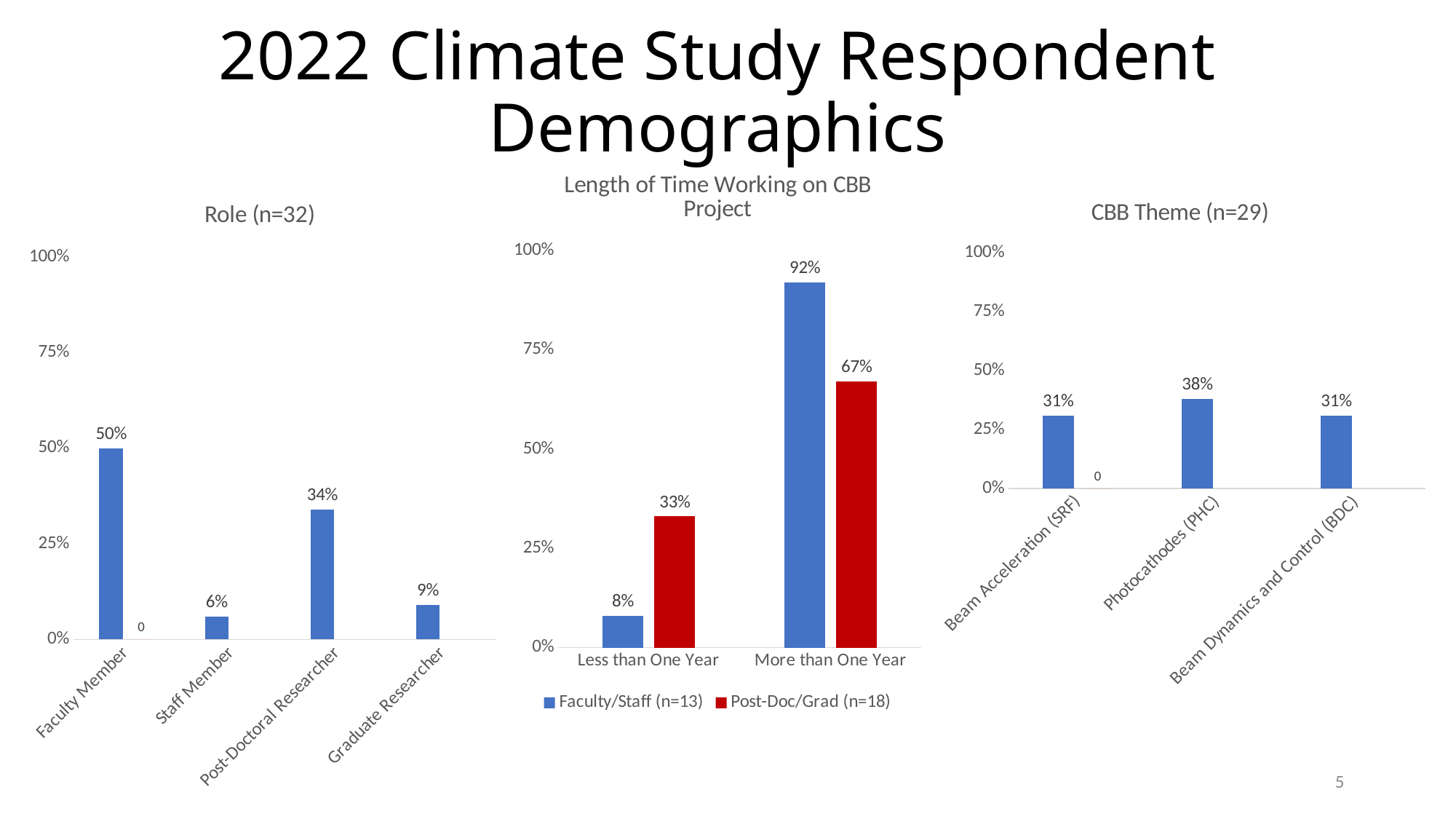
In the 'CBB Theme (n=29)' chart, what is the value for Beam Dynamics and Control (BDC)? 31% In the 'Role (n=32)' chart, what is the value for Faculty Member? 50% In the 'Length of Time Working on CBB Project' chart, how many series does the legend list? 2 In the 'Length of Time Working on CBB Project' chart, what is the value for Faculty/Staff (n=13) for More than One Year? 92% In the 'Length of Time Working on CBB Project' chart, what is the difference between the Faculty/Staff (n=13) and Post-Doc/Grad (n=18) values for Less than One Year? 25% In the 'Length of Time Working on CBB Project' chart, what is the value for Post-Doc/Grad (n=18) for Less than One Year? 33% In the 'Role (n=32)' chart, which category has the lowest value? Staff Member What kind of chart is the 'CBB Theme (n=29)' chart? Bar chart In the 'Role (n=32)' chart, how many categories are shown on the x axis? 4 In the 'Role (n=32)' chart, what is the difference between Faculty Member and Post-Doctoral Researcher? 16% In the 'CBB Theme (n=29)' chart, which category has the highest value? Photocathodes (PHC) In the 'Length of Time Working on CBB Project' chart, which is larger for More than One Year: Faculty/Staff (n=13) or Post-Doc/Grad (n=18)? Faculty/Staff (n=13)